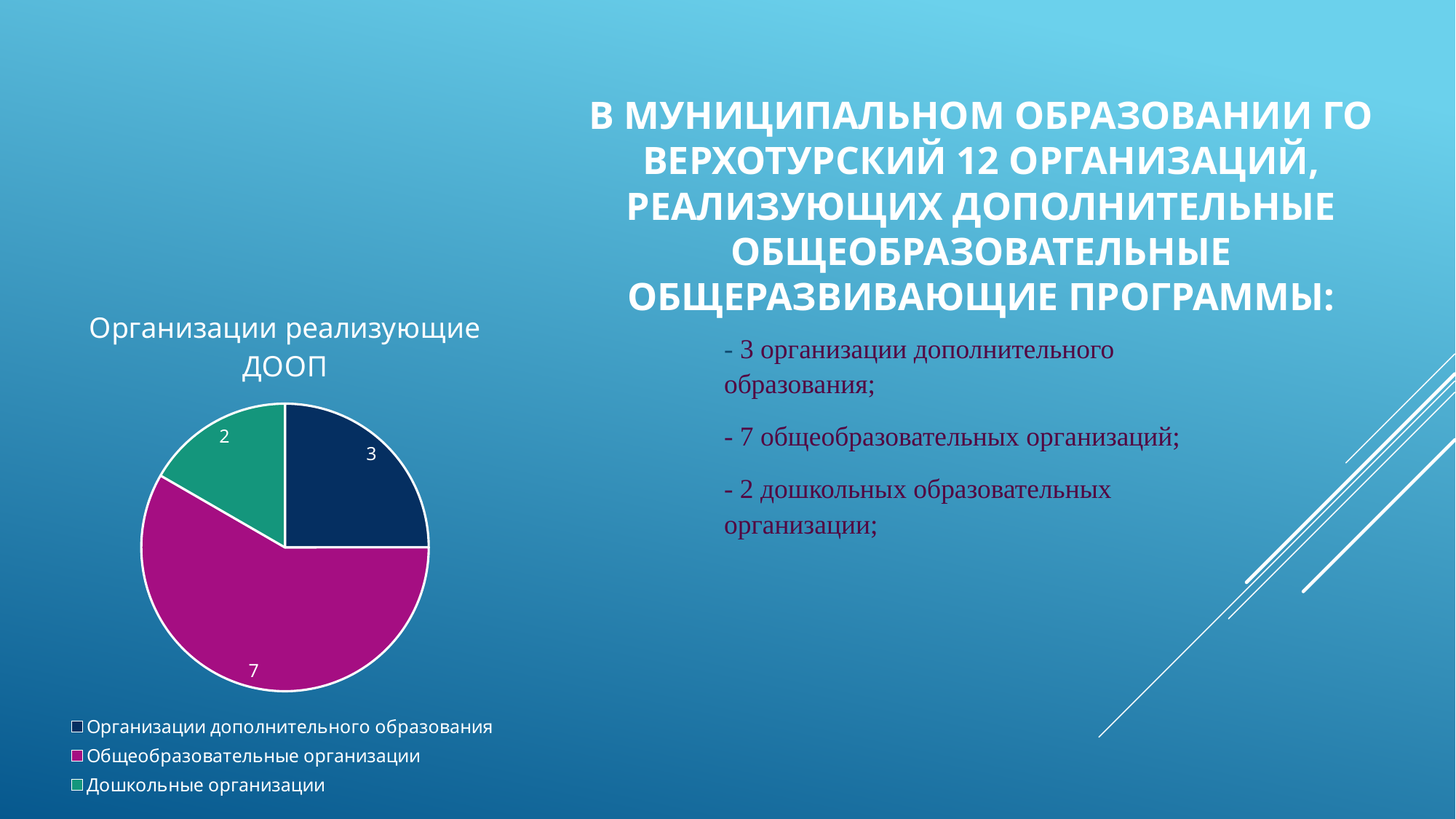
What is the value for Организации дополнительного образования? 3 Which category has the largest slice? Общеобразовательные организации What kind of chart is shown on the slide? Pie chart Which category has the smallest slice? Дошкольные организации What is the title of the chart? Организации реализующие ДООП What is the total of all slices in the pie chart? 12 How many categories does the pie chart have? 3 What is the value for Дошкольные организации? 2 Which is larger: Организации дополнительного образования or Дошкольные организации? Организации дополнительного образования What is the value for Общеобразовательные организации? 7 What is the difference between the values for Общеобразовательные организации and Организации дополнительного образования? 4 What colour is the slice for Дошкольные организации? Green